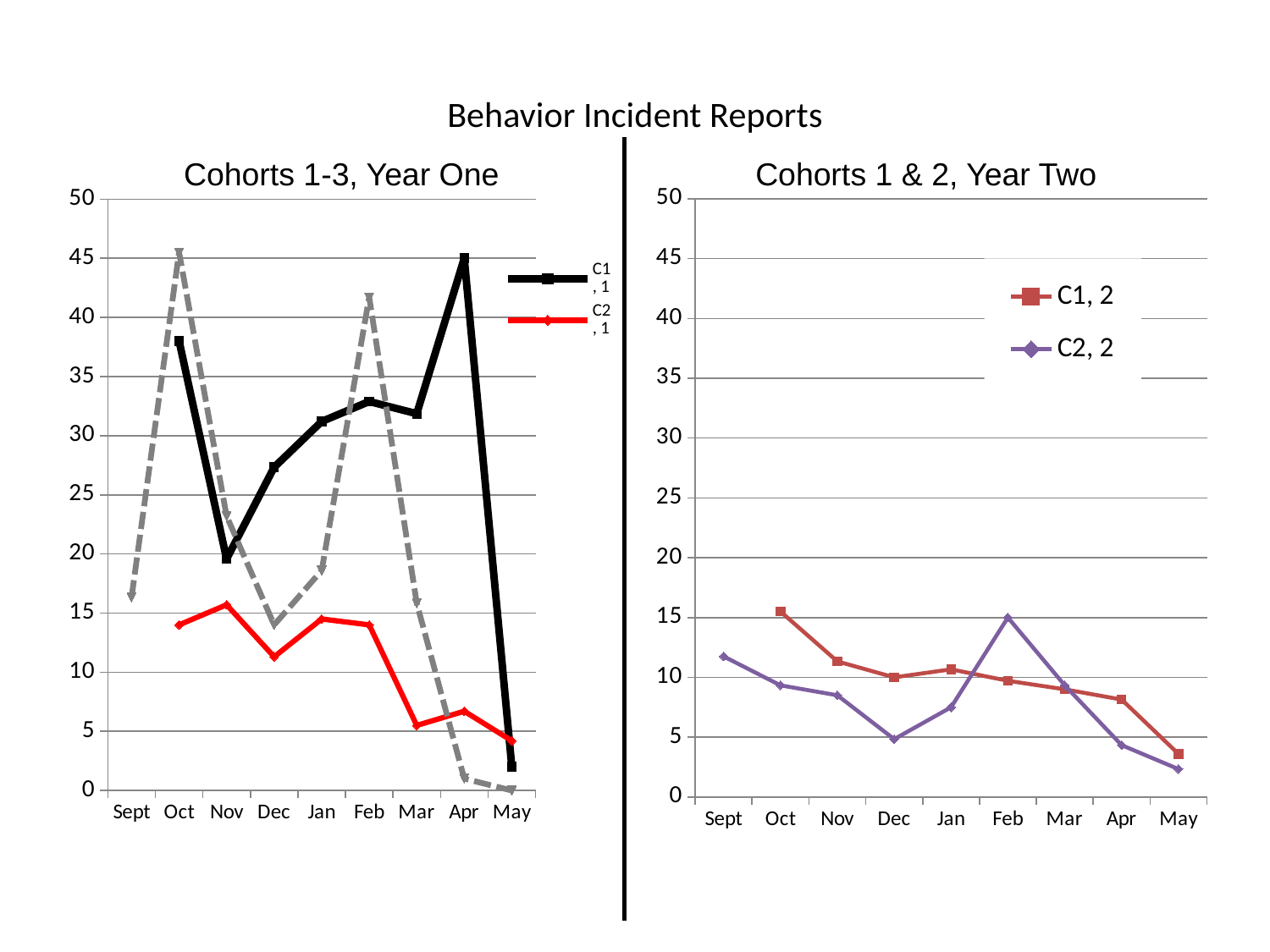
In the 'Cohorts 1-3, Year One' chart, in which month does the C1, 1 series reach its highest value? Apr What kind of chart is the 'Cohorts 1 & 2, Year Two' chart? line chart In the 'Cohorts 1-3, Year One' chart, is the value for C1, 1 in Oct greater or less than 35? greater In the 'Cohorts 1-3, Year One' chart, is the value for C2, 1 in Mar greater or less than 10? less In the 'Cohorts 1 & 2, Year Two' chart, in which month does the C2, 2 series reach its highest value? Feb In the 'Cohorts 1-3, Year One' chart, in which month does the C1, 1 series reach its lowest value? May What is the title shown at the top of the slide above both charts? Behavior Incident Reports In the 'Cohorts 1 & 2, Year Two' chart, does the C1, 2 series generally rise or fall from Oct to May? fall In the 'Cohorts 1 & 2, Year Two' chart, in which month does the C1, 2 series reach its lowest value? May In the 'Cohorts 1 & 2, Year Two' chart, how many series does the legend list? 2 In the 'Cohorts 1 & 2, Year Two' chart, how many months are shown on the x axis? 9 In the 'Cohorts 1 & 2, Year Two' chart, which series has the larger value in Feb, C1, 2 or C2, 2? C2, 2